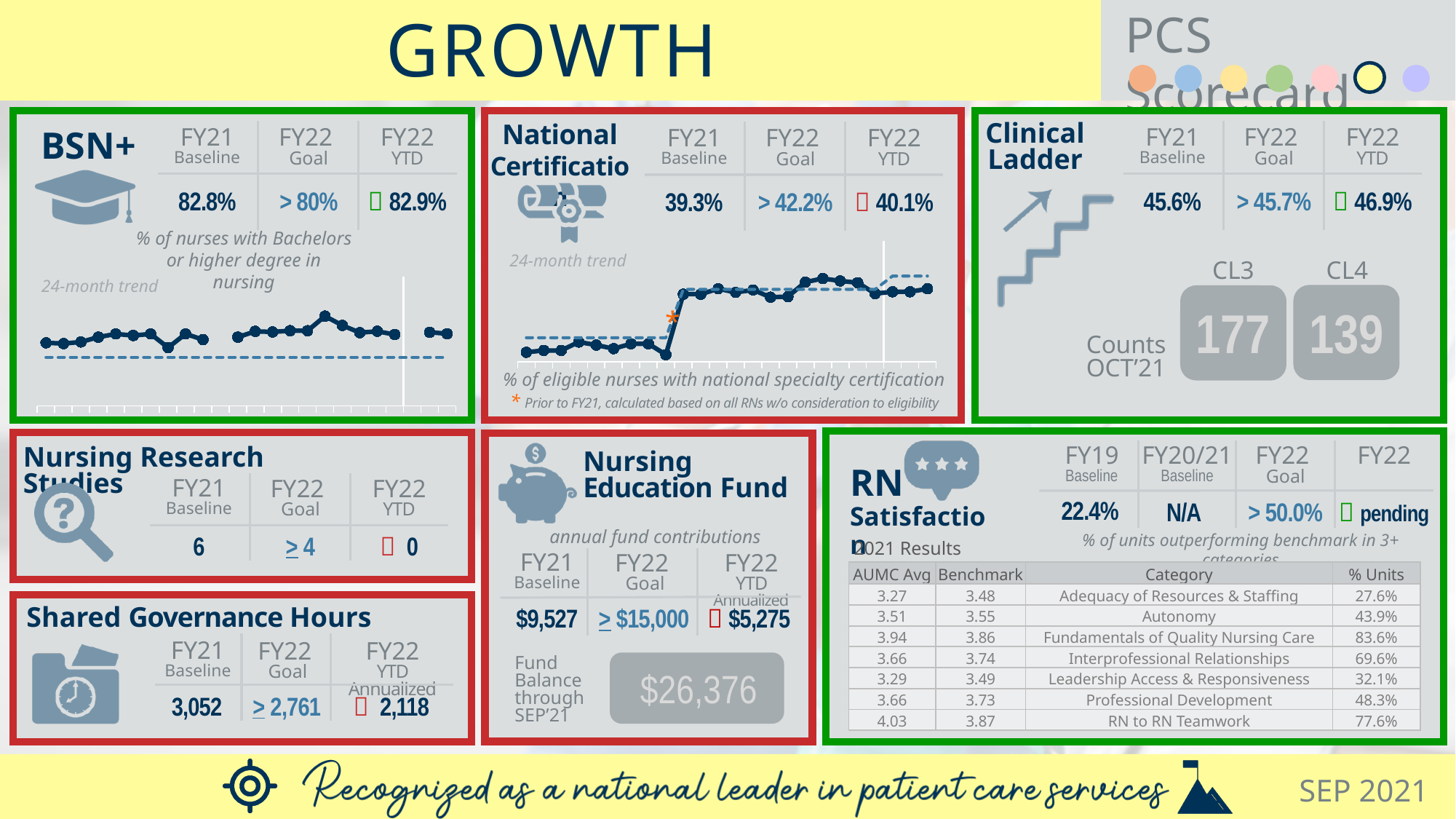
What label is printed above the line chart in the BSN+ panel? 24-month trend In the BSN+ panel, what kind of chart is the 24-month trend? line chart Which panel's trend chart has an orange asterisk marking a point on the line? National Certification In the National Certification 24-month trend chart, do the plotted values overall rise or fall from left to right? rise In the National Certification panel, what kind of chart is the 24-month trend? line chart